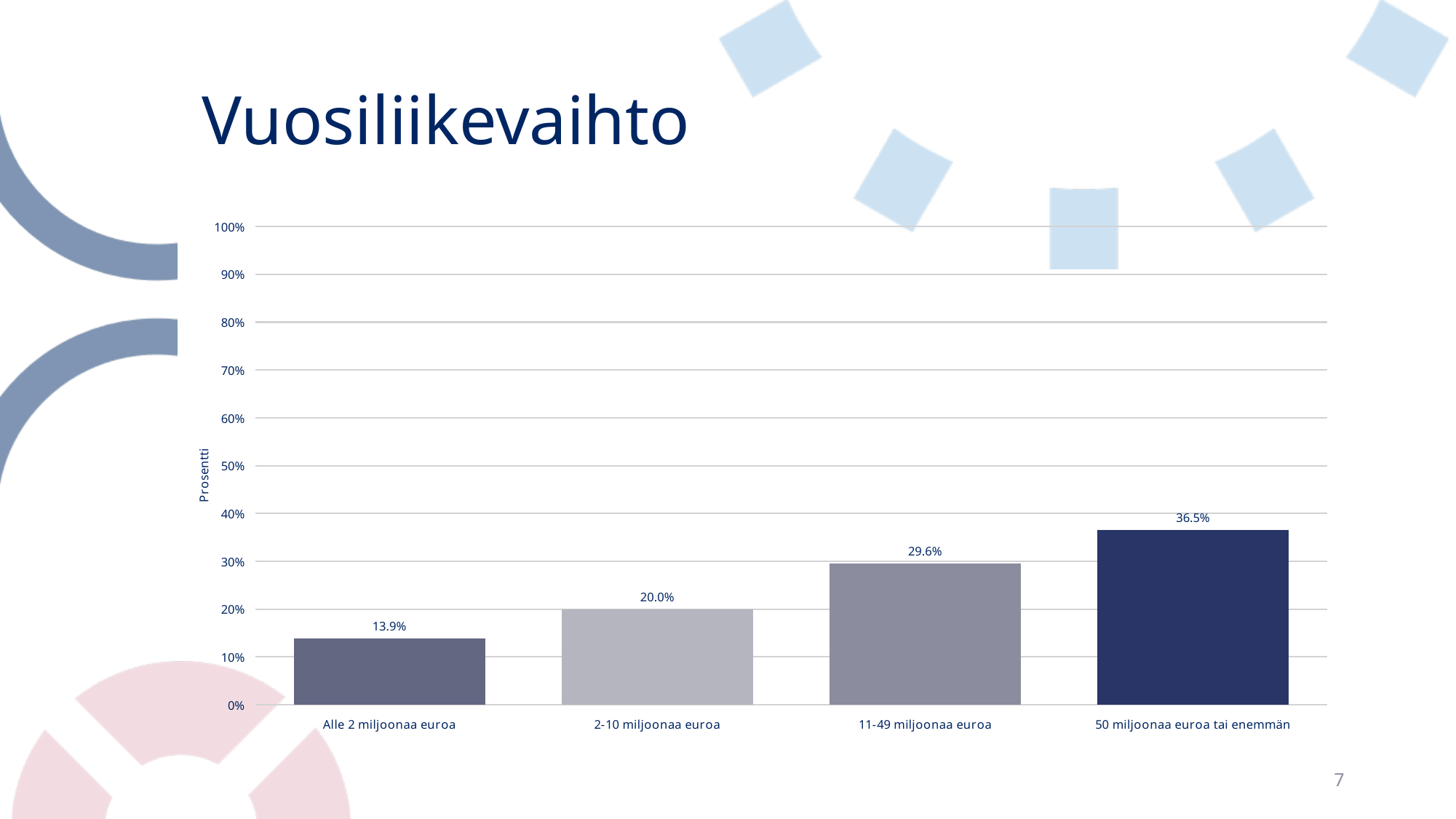
What is the value for "Alle 2 miljoonaa euroa"? 13.9% How many categories are shown on the x axis? 4 Do the values rise or fall from left to right along the x axis? rise What is the value for "11-49 miljoonaa euroa"? 29.6% What kind of chart is shown on the slide? bar chart Which is larger, the value for "2-10 miljoonaa euroa" or "11-49 miljoonaa euroa"? 11-49 miljoonaa euroa Which category has the highest value? 50 miljoonaa euroa tai enemmän What is the difference between the values for "50 miljoonaa euroa tai enemmän" and "Alle 2 miljoonaa euroa"? 22.6% What is the value for "50 miljoonaa euroa tai enemmän"? 36.5% What is the value for "2-10 miljoonaa euroa"? 20.0% Is the value for "11-49 miljoonaa euroa" greater or less than 40%? less Which category has the lowest value? Alle 2 miljoonaa euroa